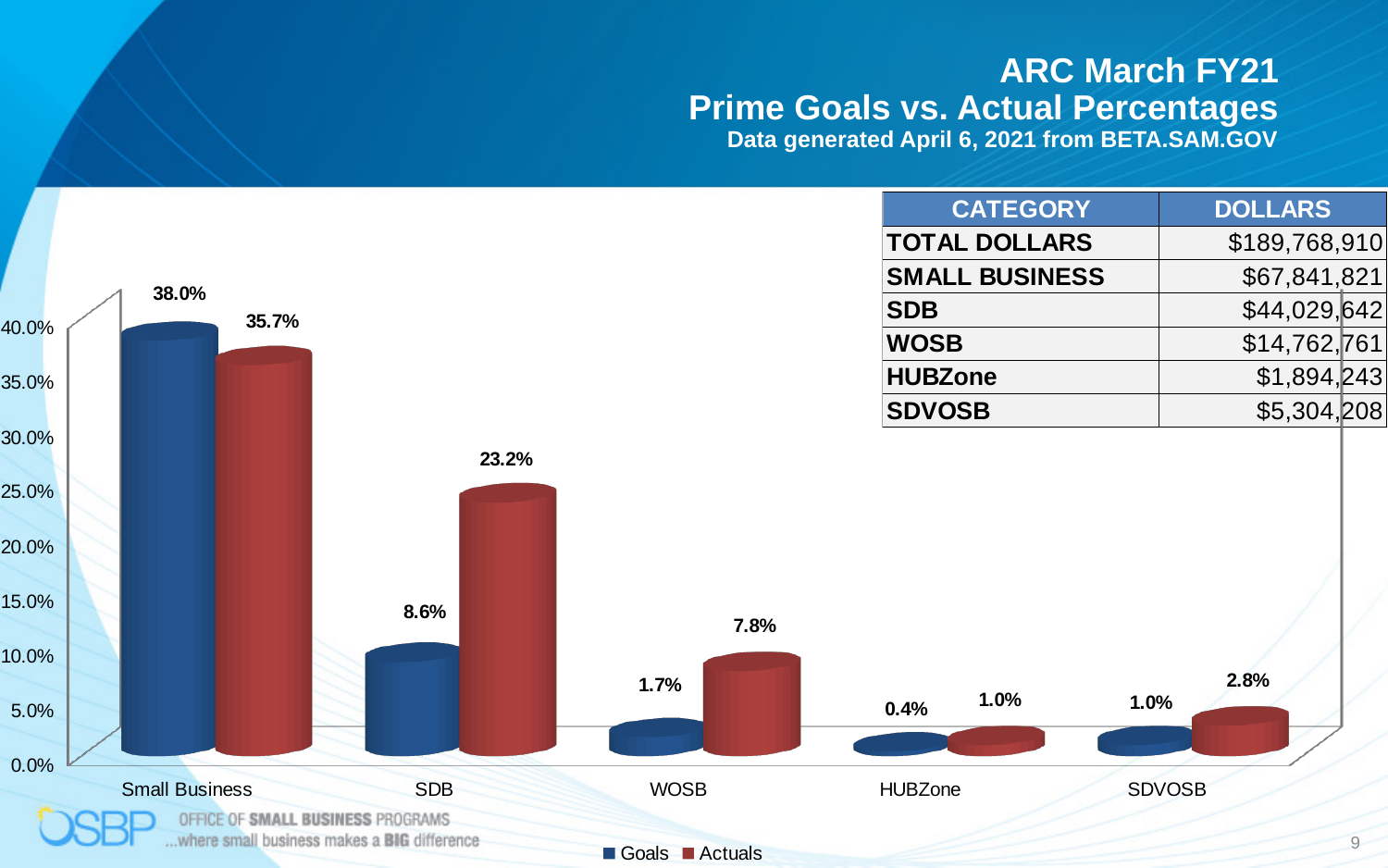
What is the Goals value for HUBZone? 0.4% Which is larger for Small Business, the Goals value or the Actuals value? Goals Which category has the highest Actuals value? Small Business Which category has the lowest Goals value? HUBZone What are the two series named in the legend? Goals and Actuals What is the Actuals value for WOSB? 7.8% What is the Actuals value for SDB? 23.2% What is the difference between the Actuals and Goals values for SDB? 14.6% What is the Goals value for Small Business? 38.0% What kind of chart is shown on the slide? Bar chart How many series does the legend list? 2 How many categories are shown on the x axis? 5